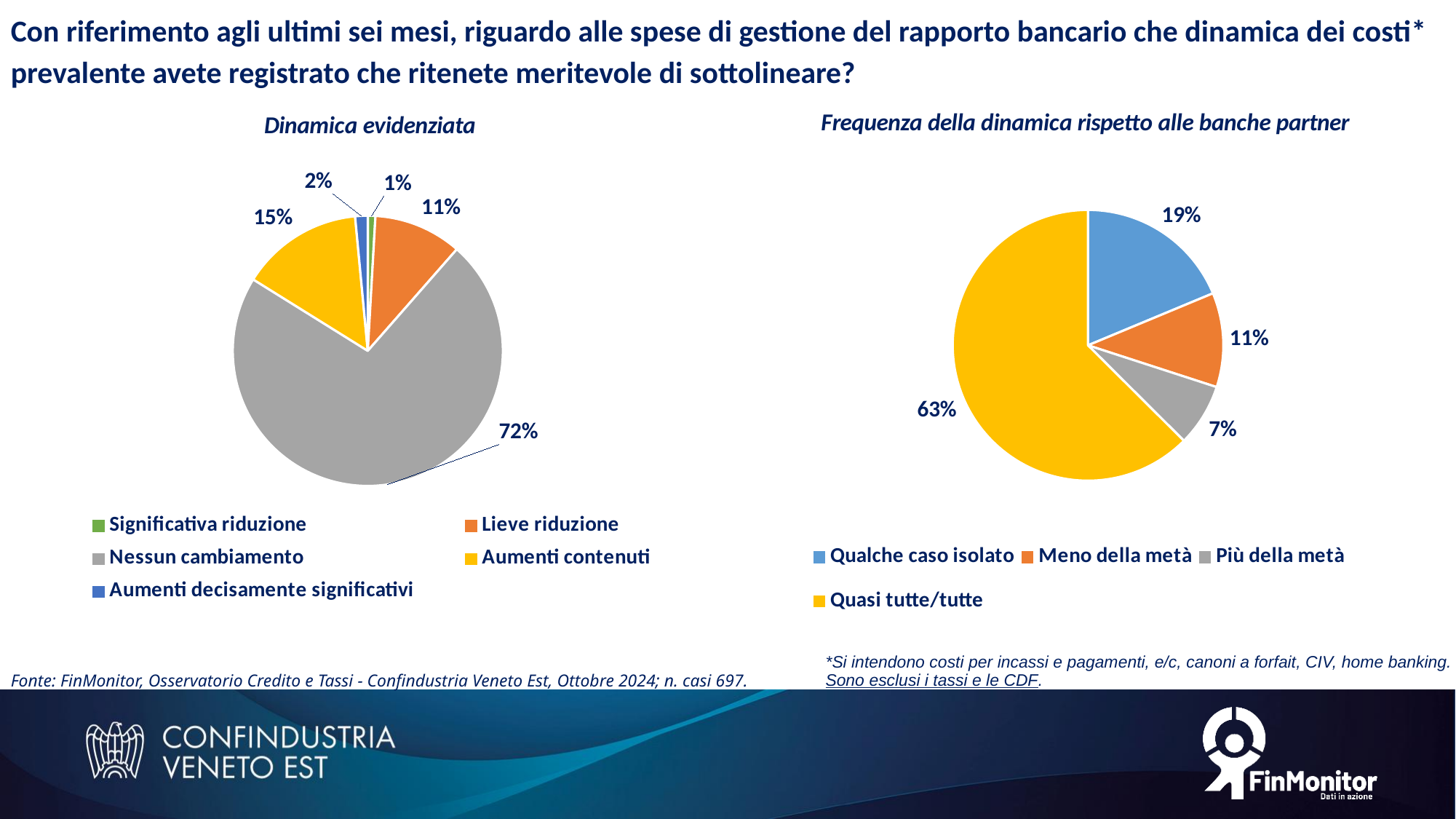
In the 'Dinamica evidenziata' chart, what is the value for 'Lieve riduzione'? 11% In the 'Dinamica evidenziata' chart, which category has the smallest slice? Significativa riduzione In the 'Dinamica evidenziata' chart, what share is 'Nessun cambiamento'? 72% How many categories does the 'Dinamica evidenziata' chart show? 5 In the 'Frequenza della dinamica rispetto alle banche partner' chart, what share is 'Quasi tutte/tutte'? 63% In the 'Frequenza della dinamica rispetto alle banche partner' chart, what is the value for 'Più della metà'? 7% In the 'Dinamica evidenziata' chart, what is the value for 'Aumenti contenuti'? 15% In the 'Frequenza della dinamica rispetto alle banche partner' chart, which is larger: 'Qualche caso isolato' or 'Meno della metà'? Qualche caso isolato In the 'Frequenza della dinamica rispetto alle banche partner' chart, what is the difference between 'Qualche caso isolato' and 'Più della metà'? 12% In the 'Frequenza della dinamica rispetto alle banche partner' chart, what colour is the 'Quasi tutte/tutte' slice? Yellow In the 'Dinamica evidenziata' chart, what is the difference between 'Aumenti contenuti' and 'Lieve riduzione'? 4% What kind of chart is 'Frequenza della dinamica rispetto alle banche partner'? Pie chart